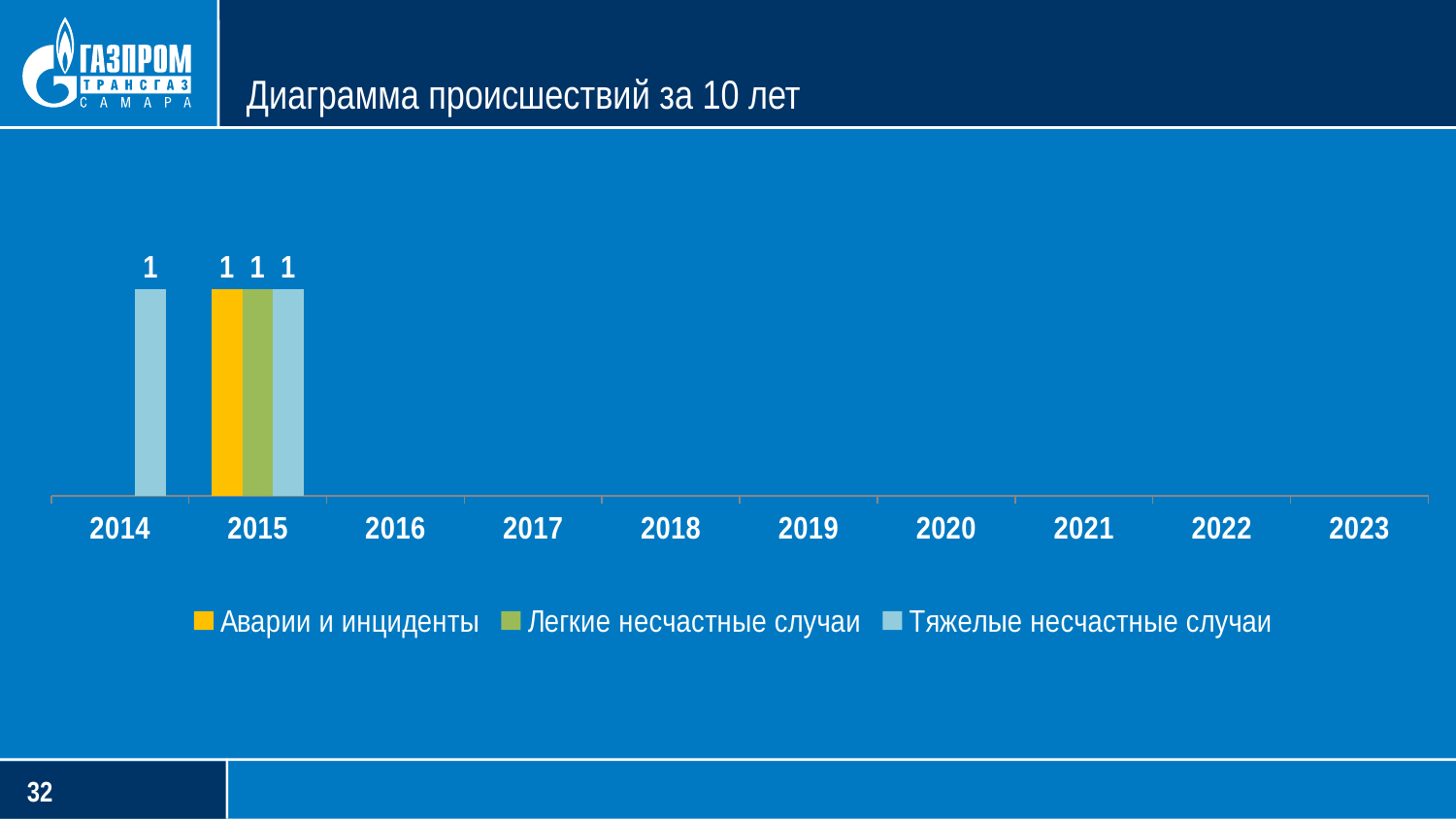
What is the value for Тяжелые несчастные случаи in 2015? 1 Which year is the only one with bars for all three series? 2015 What is the first year shown on the x axis? 2014 What is the difference between the Аварии и инциденты value in 2015 and the Тяжелые несчастные случаи value in 2014? 0 What is the value for Аварии и инциденты in 2015? 1 How many years are shown on the x axis of the chart? 10 What is the value for Легкие несчастные случаи in 2015? 1 What kind of chart is shown on the slide? bar chart How many series does the chart legend list? 3 What is the title of the chart slide? Диаграмма происшествий за 10 лет What is the value for Тяжелые несчастные случаи in 2014? 1 What is the total of the three series' values shown for 2015? 3